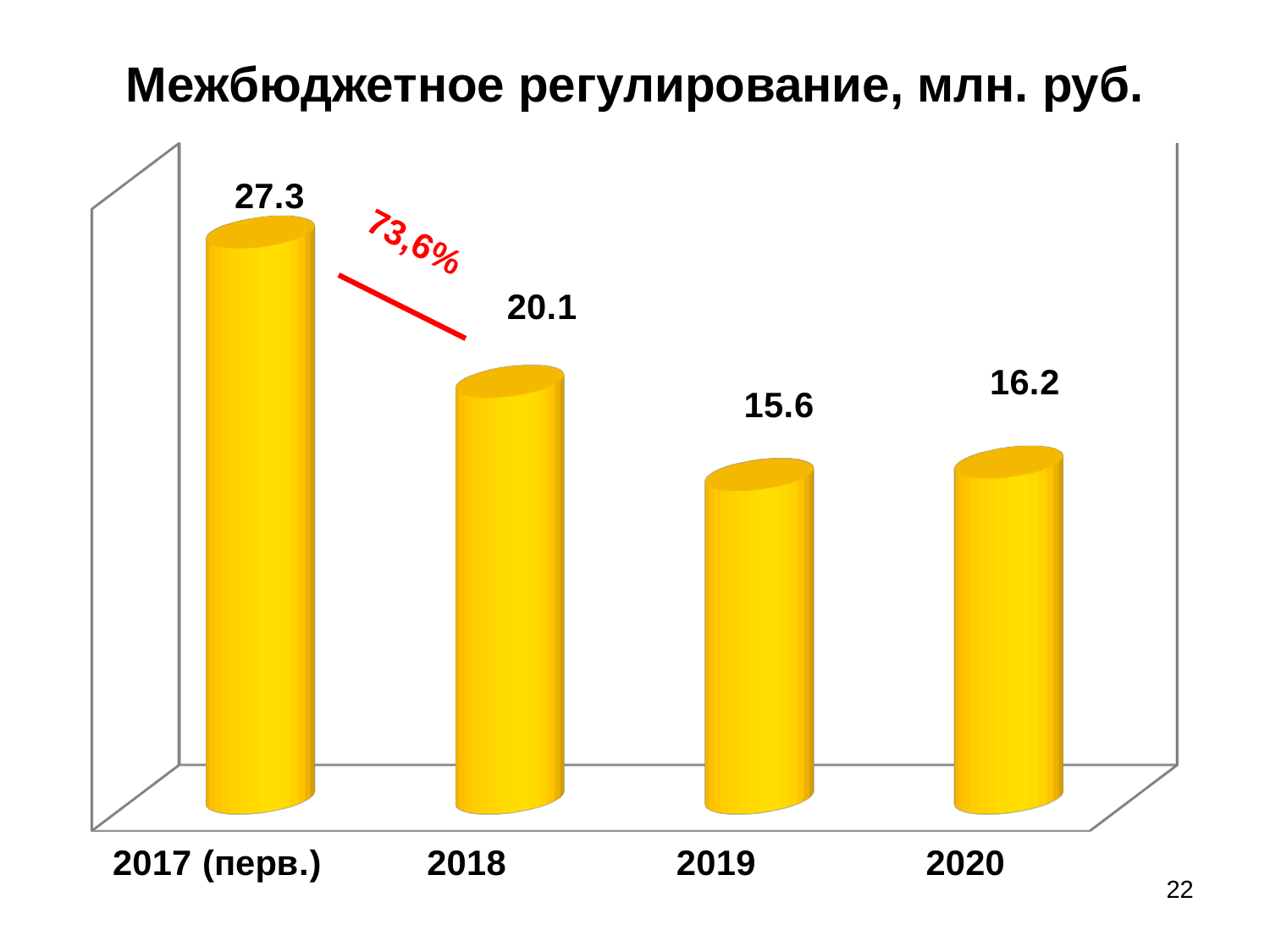
What is the value for 2017 (перв.)? 27.3 What kind of chart is shown on the slide? bar chart Which year has the lowest value? 2019 What is the value for 2020? 16.2 Do the values rise or fall from 2017 (перв.) to 2019? fall What percentage is written in red between the 2017 (перв.) and 2018 bars? 73,6% What is the difference between the values for 2020 and 2019? 0.6 Which is larger, the value for 2018 or the value for 2020? 2018 What is the difference between the values for 2017 (перв.) and 2018? 7.2 How many categories are shown on the x axis? 4 Which year has the highest value? 2017 (перв.) What is the value for 2018? 20.1